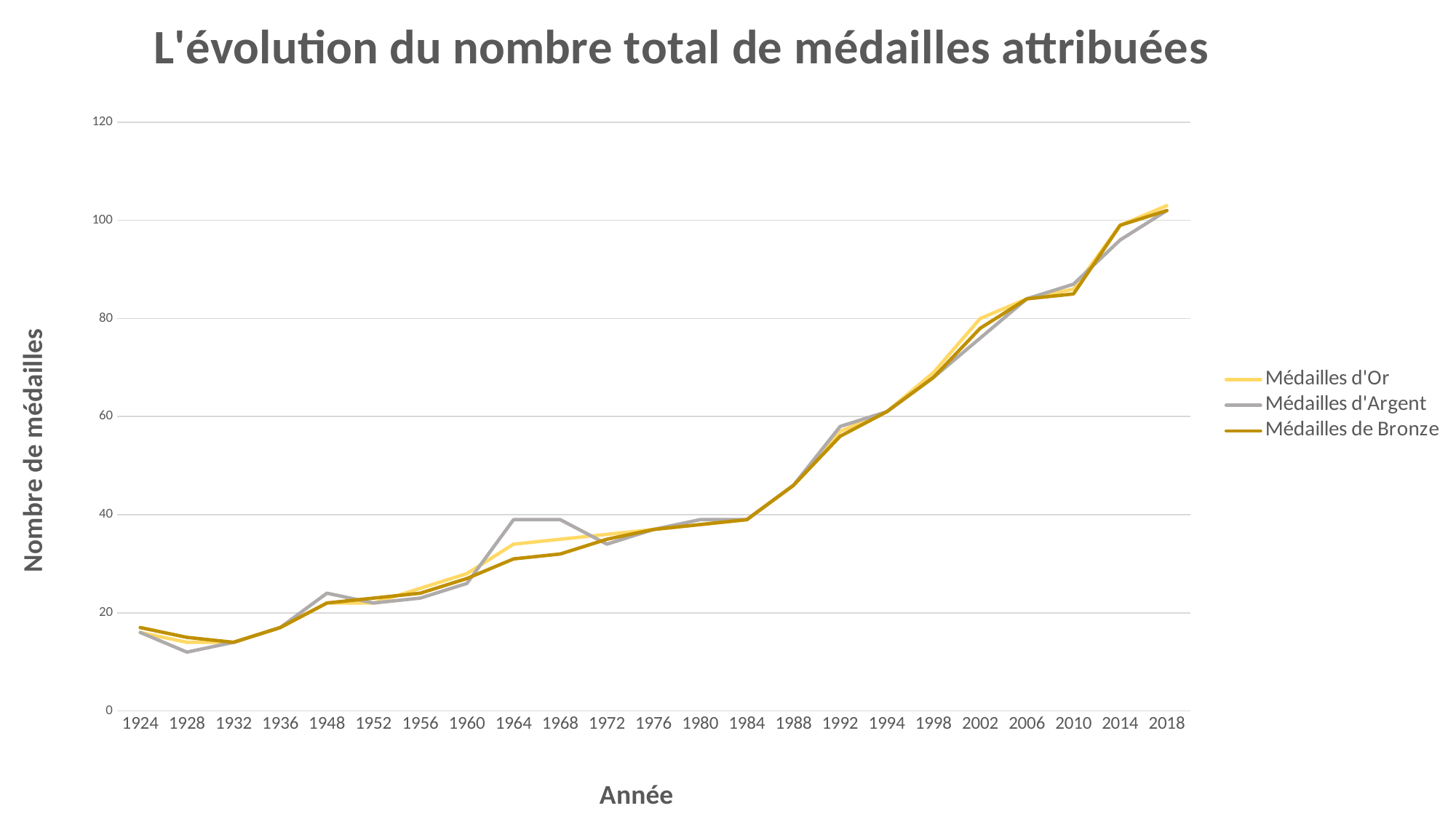
In which year is the value for Médailles d'Argent lowest? 1928 In which year is the value for Médailles d'Argent highest? 2018 Is the value for Médailles d'Argent in 1928 greater or less than 20? less In 1964, which is larger: the value for Médailles d'Argent or the value for Médailles de Bronze? Médailles d'Argent Is the value for Médailles de Bronze in 1988 greater or less than 40? greater What is the label of the y axis? Nombre de médailles How many series does the legend list? 3 What is the title of the chart? L'évolution du nombre total de médailles attribuées What kind of chart is shown on the slide? line chart Do the values for Médailles d'Or generally rise or fall from 1924 to 2018? rise Is the value for Médailles d'Argent in 1964 greater or less than 20? greater How many years are plotted along the x axis? 23